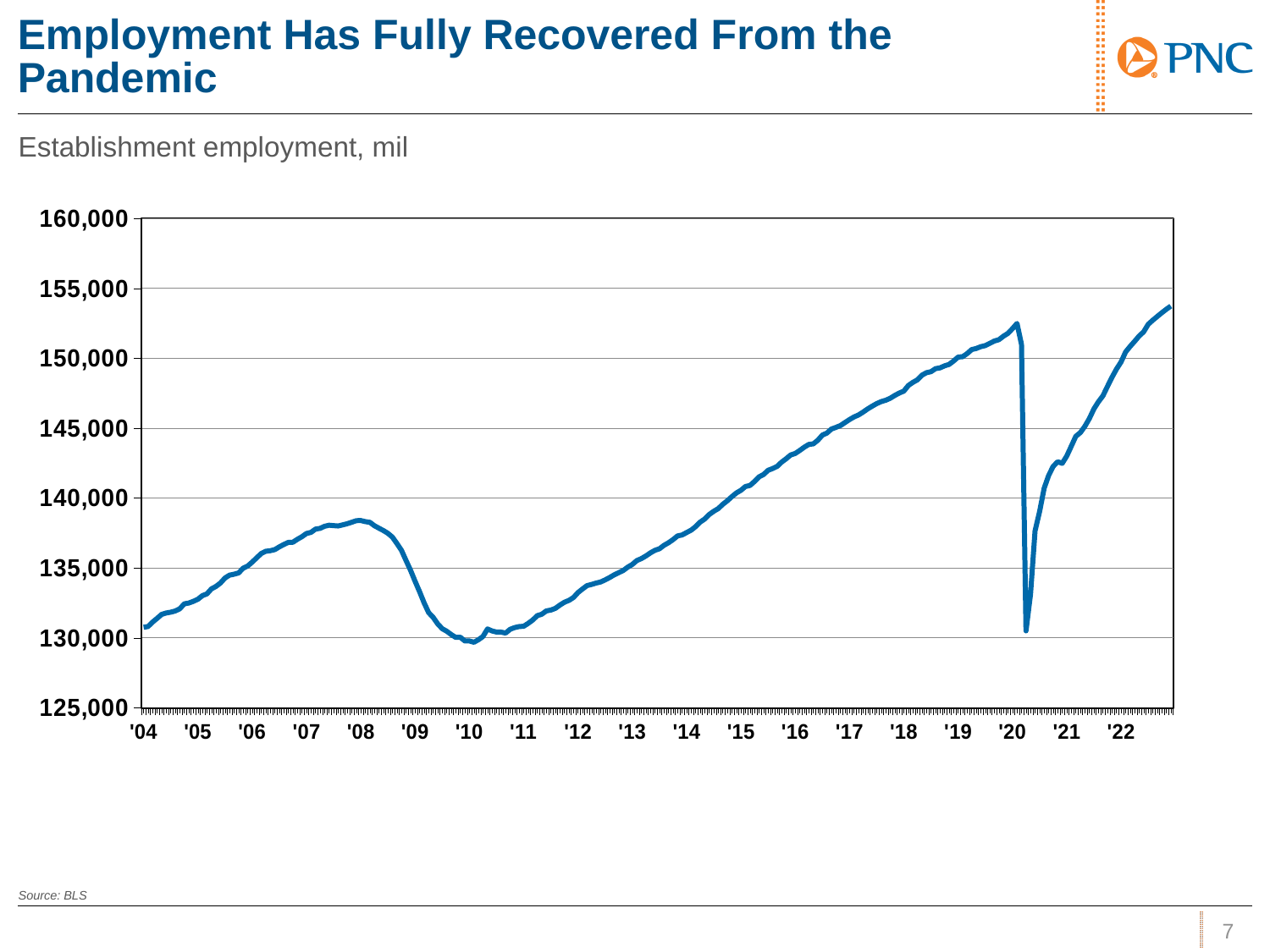
Is the value at the start of the series in '04 greater or less than 135,000? less What kind of chart is shown on the slide? line chart Which is larger, the value at '14 or the value at '17? '17 Is the value at '16 greater or less than 140,000? greater What does the label above the chart say the plotted series is? Establishment employment, mil Which is larger, the value at '08 or the value at '12? '08 How many lines are plotted on the chart? 1 Between '10 and the start of '20, does the line generally rise or fall? rise What is the title of the slide containing the chart? Employment Has Fully Recovered From the Pandemic Is the value at '10 greater or less than 135,000? less How many year labels are shown along the x axis? 19